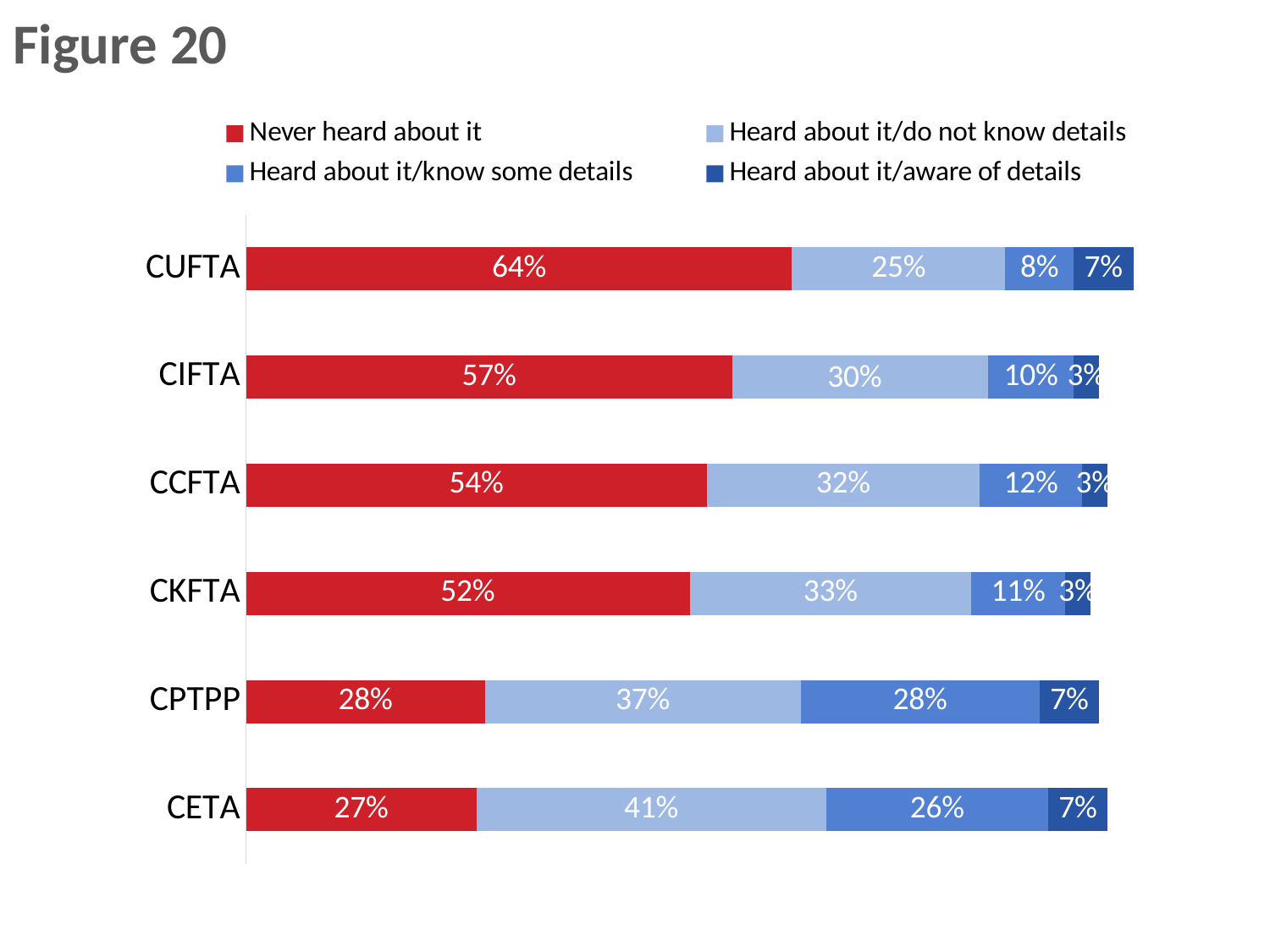
Which has a larger 'Heard about it/know some details' value, CPTPP or CETA? CPTPP What is the title of the slide? Figure 20 What type of chart is shown on the slide? Stacked bar chart Which agreement has the highest 'Heard about it/know some details' value? CPTPP What is the difference between the 'Never heard about it' values for CUFTA and CETA? 37 percentage points Which agreement has the lowest share of respondents who had never heard about it? CETA What is the 'Heard about it/aware of details' value for CKFTA? 3% How many agreements (categories) are shown in the chart? 6 What is the value for 'Heard about it/do not know details' for CETA? 41% What percentage of respondents had never heard about CUFTA? 64% How many series does the legend list? 4 Which agreement has the highest share of respondents who had never heard about it? CUFTA